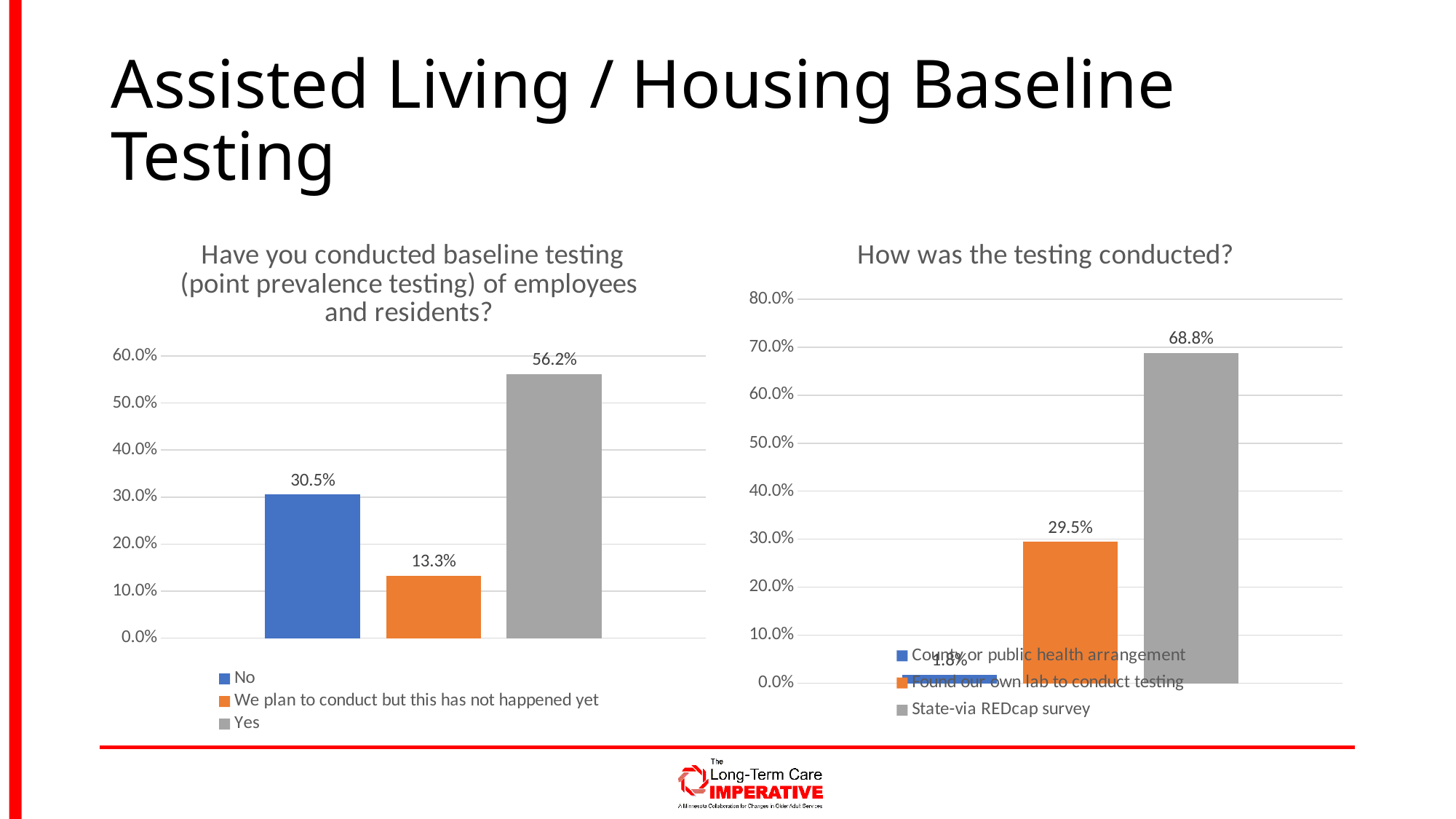
In the chart titled "How was the testing conducted?", what is the difference between the values for "State-via REDcap survey" and "Found our own lab to conduct testing"? 39.3% In the chart titled "Have you conducted baseline testing (point prevalence testing) of employees and residents?", what is the value for "Yes"? 56.2% In the chart titled "How was the testing conducted?", is the value for "State-via REDcap survey" greater or less than 60.0%? greater In the chart titled "How was the testing conducted?", what is the value for "Found our own lab to conduct testing"? 29.5% In the chart titled "How was the testing conducted?", which category has the lowest value? County or public health arrangement In the chart titled "Have you conducted baseline testing (point prevalence testing) of employees and residents?", what is the difference between the values for "Yes" and "No"? 25.7% In the chart titled "Have you conducted baseline testing (point prevalence testing) of employees and residents?", how many legend entries are listed? 3 What kind of chart is the chart titled "How was the testing conducted?"? Bar chart In the chart titled "Have you conducted baseline testing (point prevalence testing) of employees and residents?", which category has the lowest value? We plan to conduct but this has not happened yet In the chart titled "How was the testing conducted?", which category has the highest value? State-via REDcap survey In the chart titled "How was the testing conducted?", what is the value for "State-via REDcap survey"? 68.8% In the chart titled "Have you conducted baseline testing (point prevalence testing) of employees and residents?", what is the value for "No"? 30.5%